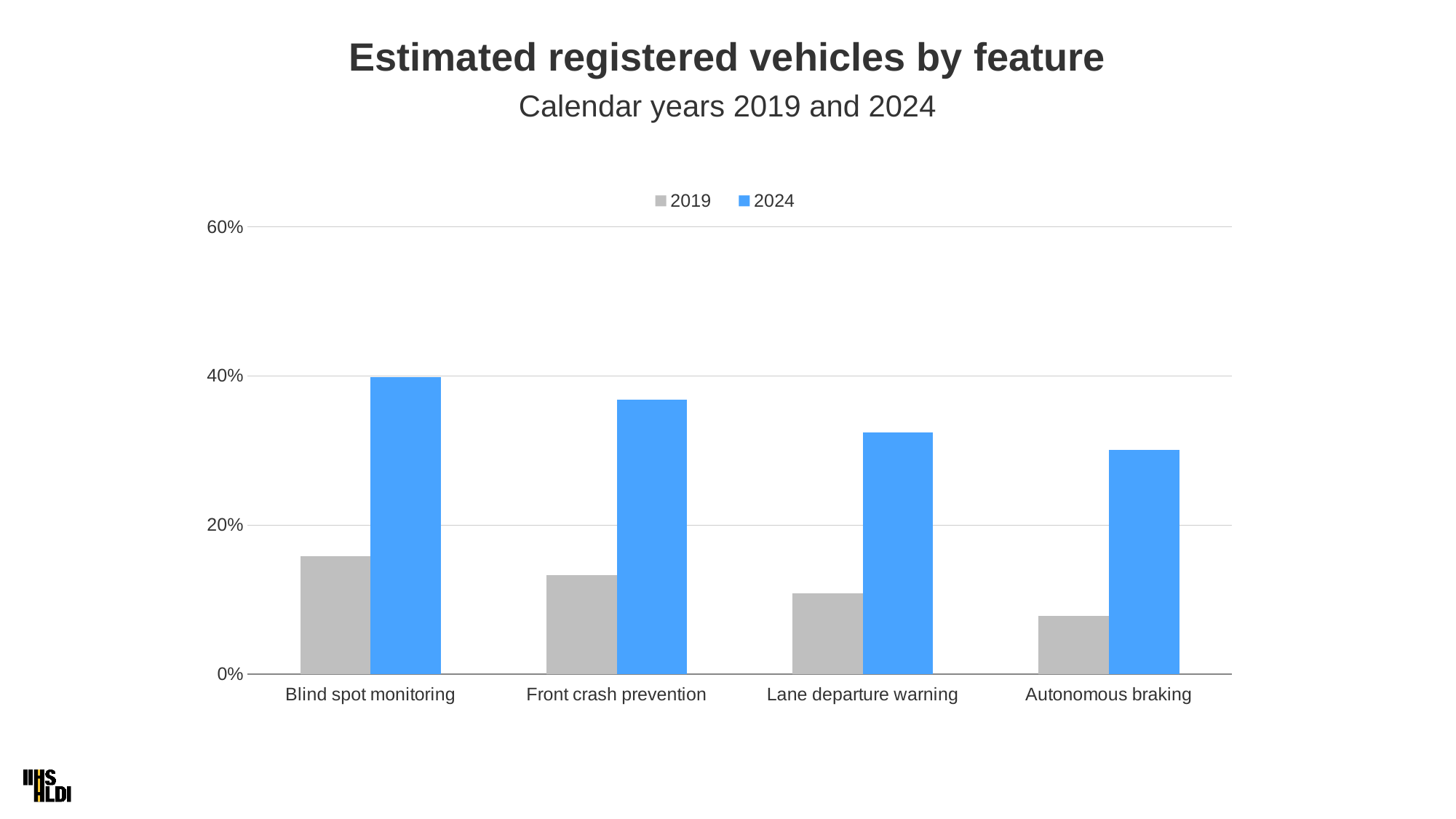
Which feature has the highest value for 2024? Blind spot monitoring For Lane departure warning, which year has the larger value, 2019 or 2024? 2024 Which colour represents the 2024 series in the legend? Blue Which feature has the lowest value for 2024? Autonomous braking Is the 2024 value for Front crash prevention greater or less than 20%? greater Which feature has the lowest value for 2019? Autonomous braking Do the 2024 values rise or fall moving from left to right across the features? Fall Is the 2019 value for Blind spot monitoring greater or less than 20%? less What kind of chart is shown on the slide? Bar chart Is the 2024 value for Autonomous braking greater or less than 40%? less How many series does the legend list? 2 How many feature categories are shown on the x axis? 4